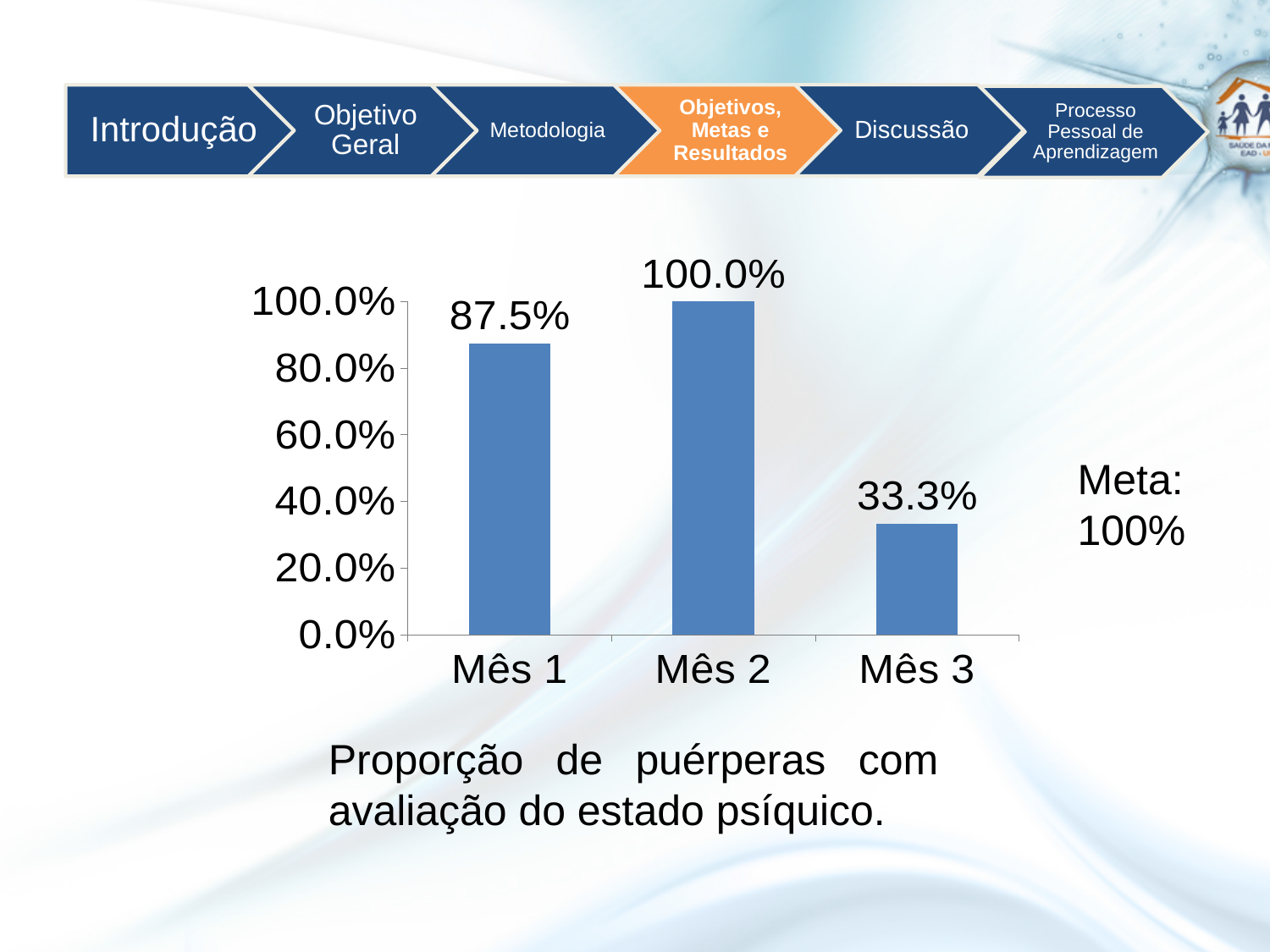
What is the value for Mês 3? 33.3% What kind of chart is shown on the slide? bar chart What is the value for Mês 1? 87.5% Which month has the lowest value? Mês 3 What is the difference between the values for Mês 2 and Mês 3? 66.7% Which month has the highest value? Mês 2 What is the difference between the values for Mês 2 and Mês 1? 12.5% What is the value for Mês 2? 100.0% What target (Meta) is stated next to the chart? 100% How many months are shown on the x axis? 3 Is the value for Mês 3 greater or less than 40.0%? less Which is larger, the value for Mês 1 or the value for Mês 3? Mês 1